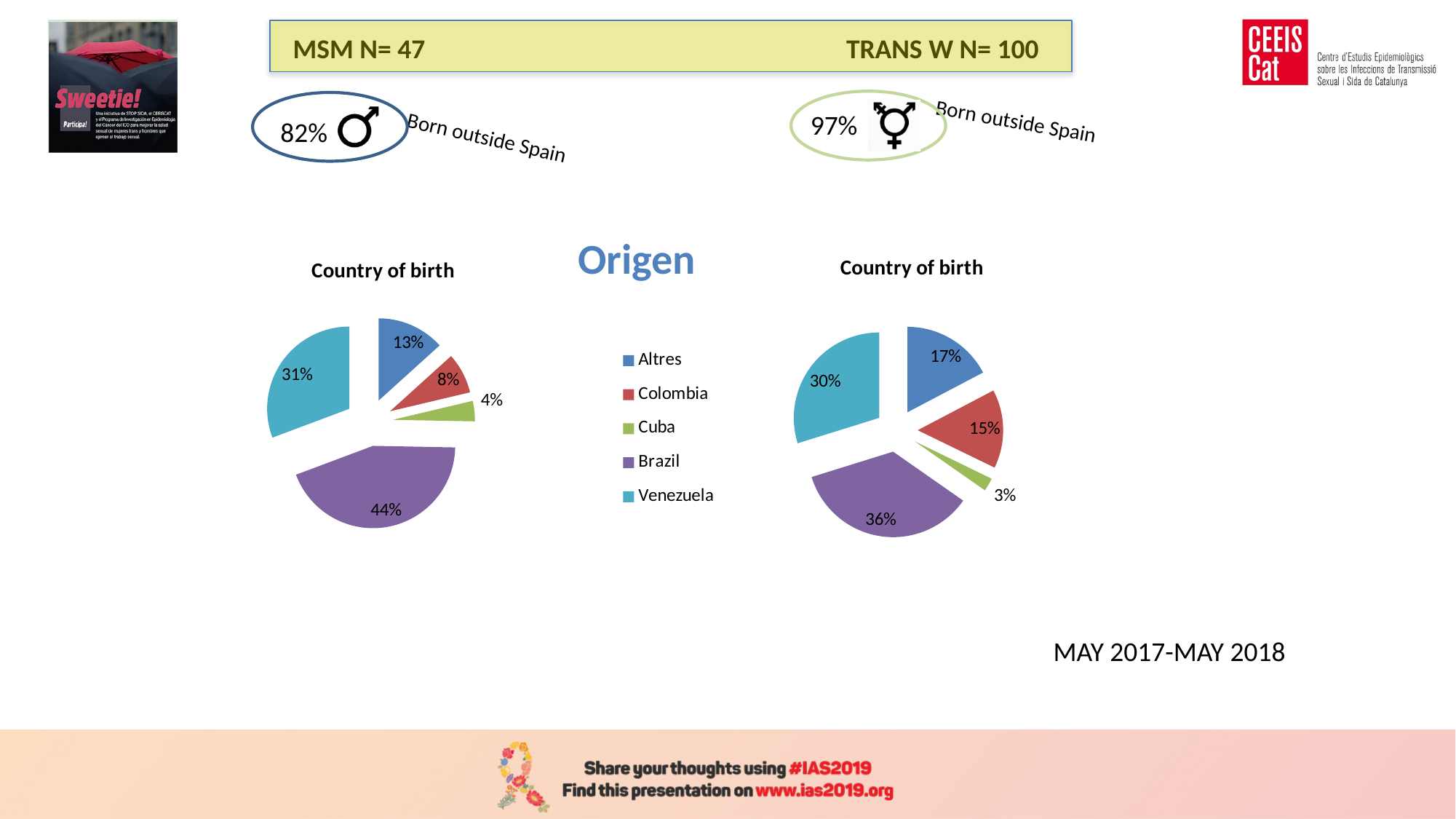
In the left pie chart (MSM, Country of birth), what share is Brazil? 44% How many categories does the legend list for the Country of birth pie charts? 5 In the right pie chart (Trans W, Country of birth), what share is Colombia? 15% In the right pie chart (Trans W, Country of birth), what share is Venezuela? 30% In the right pie chart (Trans W, Country of birth), which is larger: Altres or Colombia? Altres In the right pie chart (Trans W, Country of birth), what is the difference between the Brazil and Altres shares? 19% What type of chart is used for Country of birth on this slide? Pie chart In the left pie chart (MSM, Country of birth), what is the difference between the Brazil and Venezuela shares? 13% In the left pie chart (MSM, Country of birth), what share is Cuba? 4% In the Country of birth legend, which colour represents Venezuela? Teal (light blue) In the right pie chart (Trans W, Country of birth), which country has the smallest share? Cuba In the left pie chart (MSM, Country of birth), which country has the largest share? Brazil